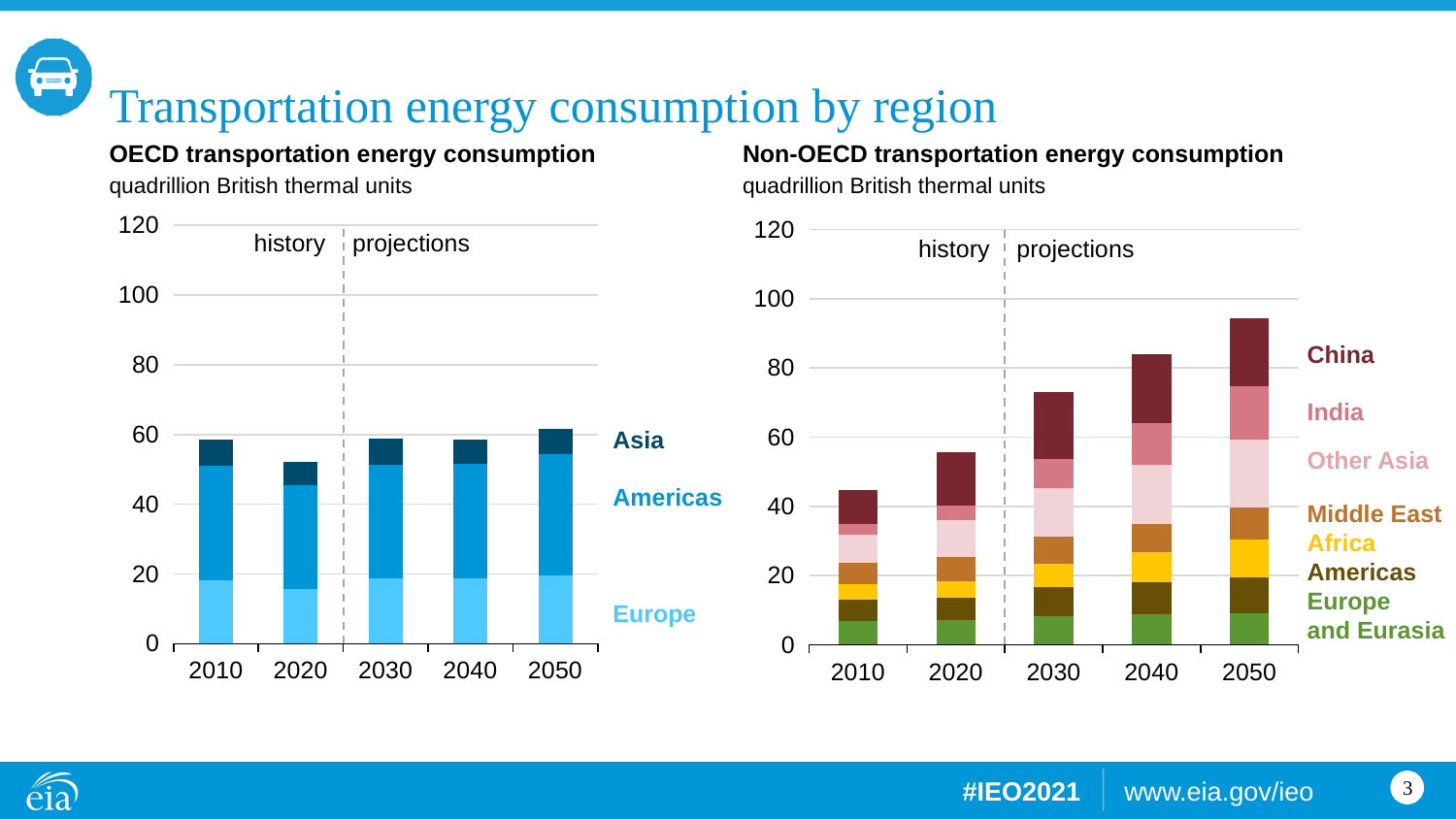
In the Non-OECD transportation energy consumption chart, which year has the highest total consumption? 2050 In the Non-OECD transportation energy consumption chart, which year has the lowest total consumption? 2010 How many series does the legend of the OECD transportation energy consumption chart list? 3 How many years are shown on the x axis of the Non-OECD transportation energy consumption chart? 5 In the Non-OECD transportation energy consumption chart, do total values rise or fall from 2010 to 2050? rise How many series does the legend of the Non-OECD transportation energy consumption chart list? 7 What unit is used on both charts on the slide? quadrillion British thermal units Which is larger in 2050: the total in the OECD transportation energy consumption chart or the total in the Non-OECD transportation energy consumption chart? Non-OECD In the OECD transportation energy consumption chart, which year has the lowest total consumption? 2020 In the Non-OECD transportation energy consumption chart, is the total value for 2050 greater or less than 100? less In the OECD transportation energy consumption chart, is the total value for 2020 greater or less than 60? less What kind of chart is the OECD transportation energy consumption chart? stacked bar chart